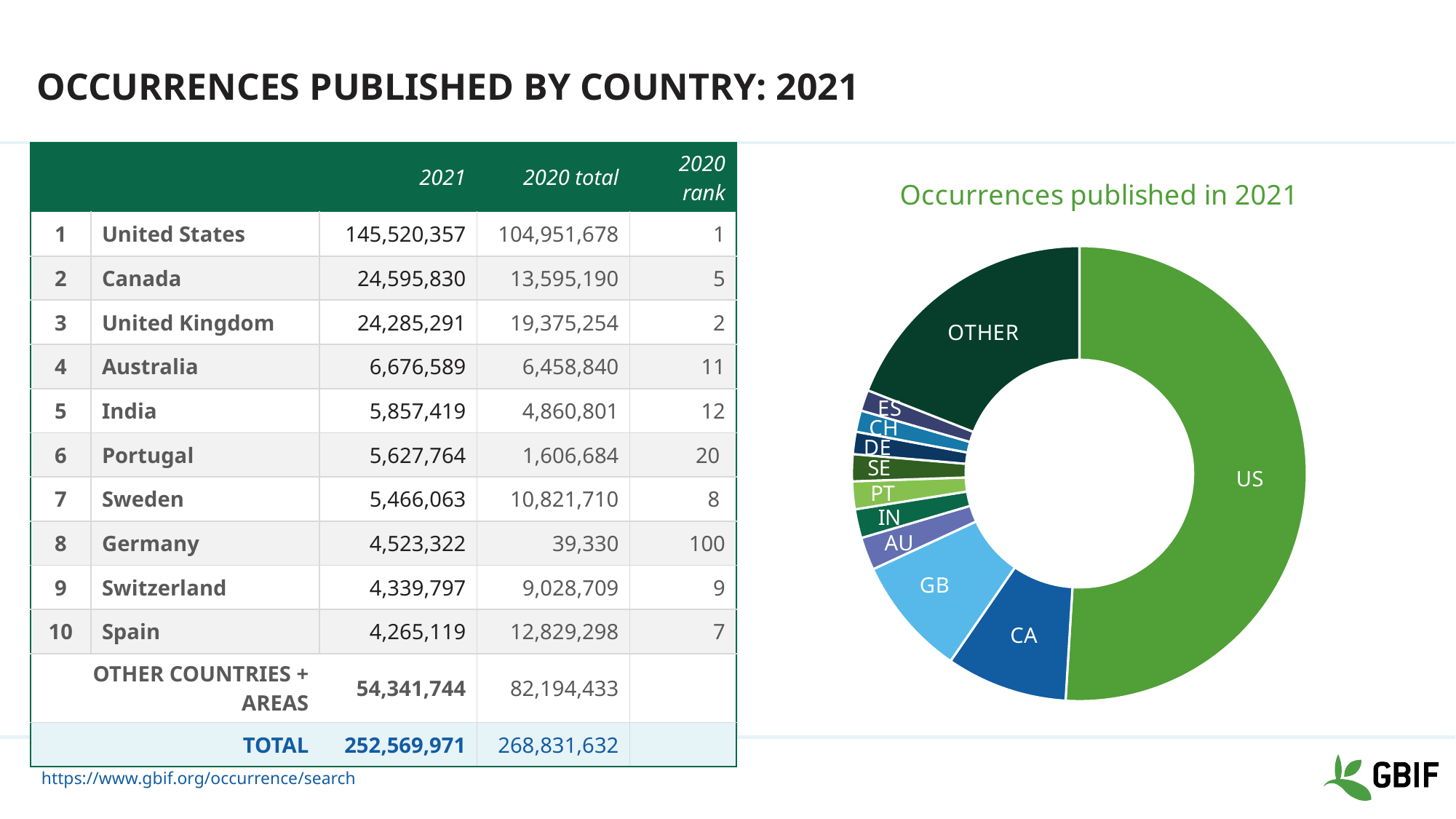
What is the title of the chart on the right of the slide? Occurrences published in 2021 According to the table, how many occurrences did Canada publish in 2021? 24,595,830 How many slices does the donut chart have? 11 What kind of chart is shown on the right of the slide? donut chart Which slice of the donut chart is the largest? US According to the table, how many occurrences did the United States publish in 2021? 145,520,357 In the donut chart, which slice is larger, OTHER or CA? OTHER According to the table, what is the 2021 total of occurrences published? 252,569,971 In the donut chart, which slice is larger, US or OTHER? US What colour is the US slice in the donut chart? green In the donut chart, which slice is larger, GB or AU? GB Using the table values, what is the difference between the 2021 occurrences published by the United States and by Canada? 120,924,527